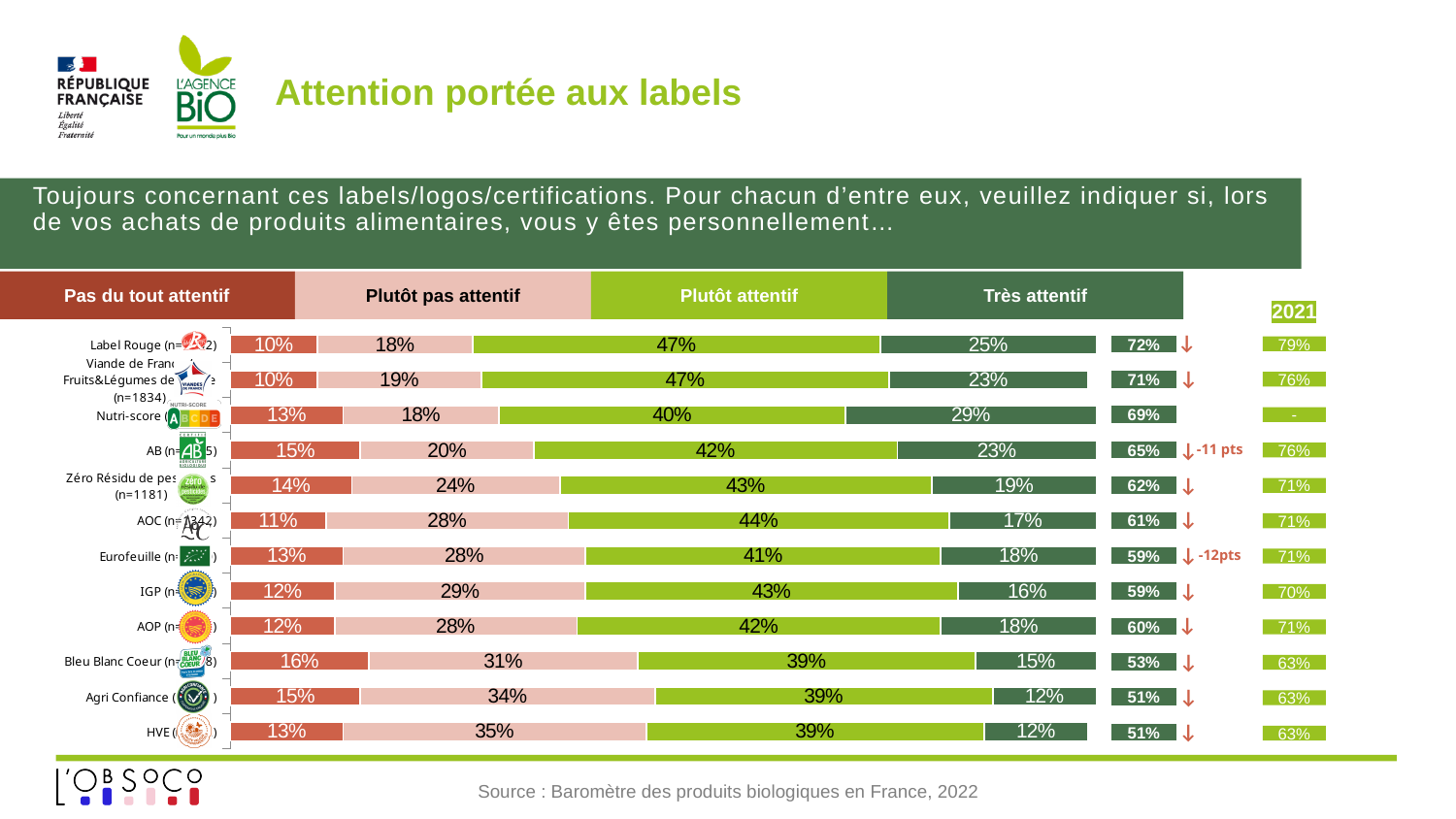
Which label has the highest 'Très attentif' value? Nutri-score What is the 'Plutôt attentif' value for Label Rouge? 47% What is the combined 'Plutôt attentif' and 'Très attentif' total shown for Agri Confiance? 51% How many series does the legend list? 4 Which label has the highest 'Plutôt pas attentif' value? HVE How many labels (categories) are plotted in the chart? 12 What is the difference between the 'Plutôt pas attentif' values for HVE and Label Rouge? 17% What is the 'Très attentif' value for Nutri-score? 29% What is the 'Pas du tout attentif' value for Bleu Blanc Coeur? 16% Which is larger: the 'Très attentif' value for AB or for AOC? AB What 2021 value is shown for Label Rouge in the right-hand column? 79% What kind of chart is shown on the slide? Stacked bar chart